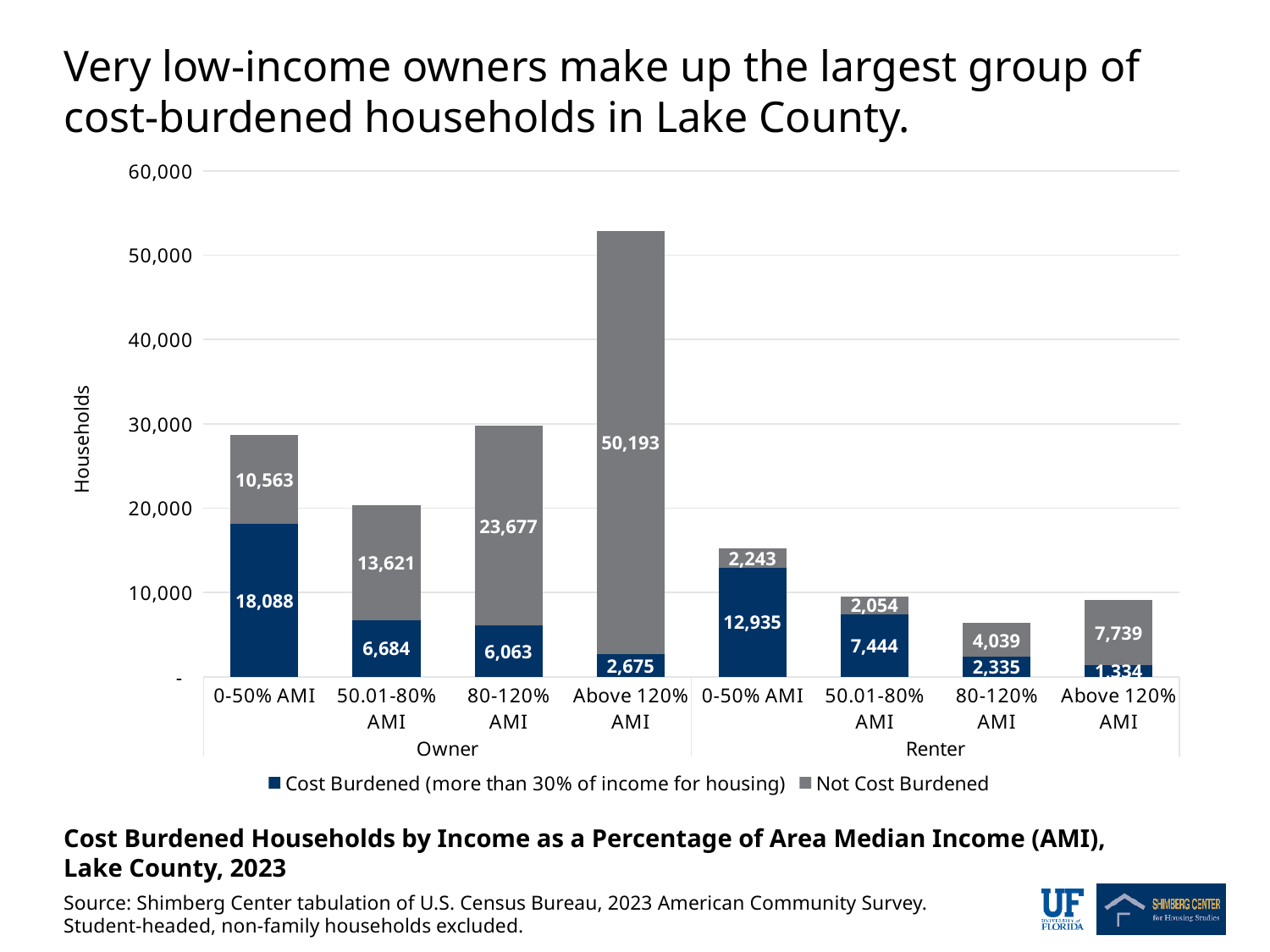
How many series does the legend list? 2 Is the total height of the Owner Above 120% AMI bar greater or less than 50,000? greater What is the total number of owner households in the 50.01-80% AMI group (cost burdened plus not cost burdened)? 20,305 What is the difference between cost-burdened owner households at 0-50% AMI and cost-burdened renter households at 0-50% AMI? 5,153 Which income group has the lowest number of cost-burdened households? Renter Above 120% AMI How many income categories (bars) are plotted in total across Owner and Renter? 8 How many not-cost-burdened owner households are in the Above 120% AMI group? 50,193 Which is larger: the number of not-cost-burdened renter households at 80-120% AMI or at Above 120% AMI? Above 120% AMI How many cost-burdened owner households are in the 0-50% AMI group? 18,088 Which income group has the highest number of cost-burdened households? Owner 0-50% AMI What kind of chart is shown on the slide? Stacked bar chart How many cost-burdened renter households are in the 50.01-80% AMI group? 7,444